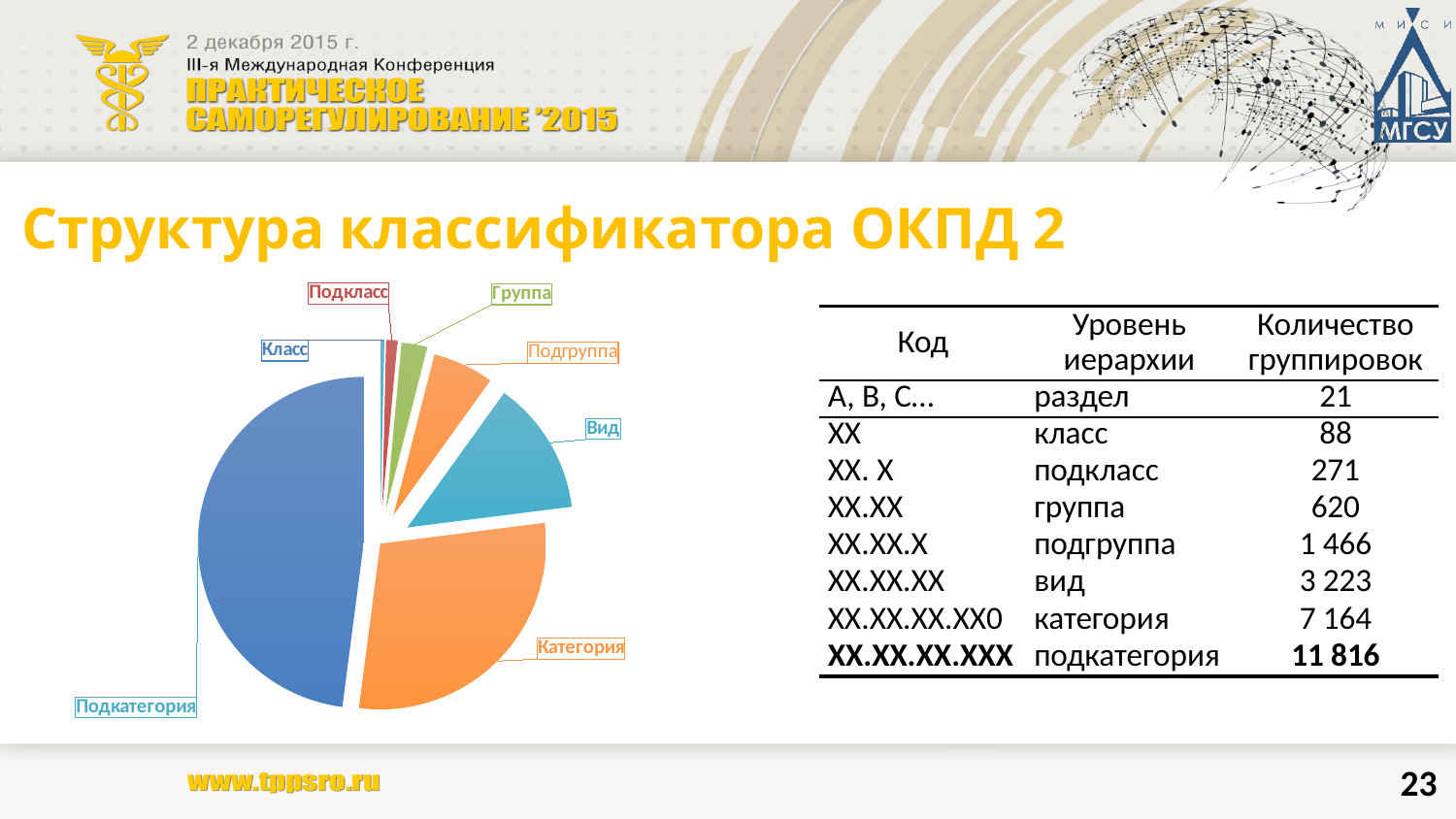
Which slice of the pie chart is the largest? Подкатегория What is the title of the slide containing the pie chart? Структура классификатора ОКПД 2 How many slices are labelled in the pie chart? 7 Which slice is larger in the pie chart, Группа or Подкласс? Группа What colour is the Подкатегория slice in the pie chart? blue Which slice is larger in the pie chart, Вид or Подгруппа? Вид Which labelled slice of the pie chart is the smallest? Класс What kind of chart is shown on the slide? pie chart According to the table next to the pie chart, how many groupings (Количество группировок) are there at the подкатегория level? 11 816 Using the table next to the pie chart, what is the difference between the number of groupings for подкатегория and категория? 4 652 According to the table next to the pie chart, how many groupings are there at the вид level? 3 223 Which slice is larger in the pie chart, Подкатегория or Категория? Подкатегория